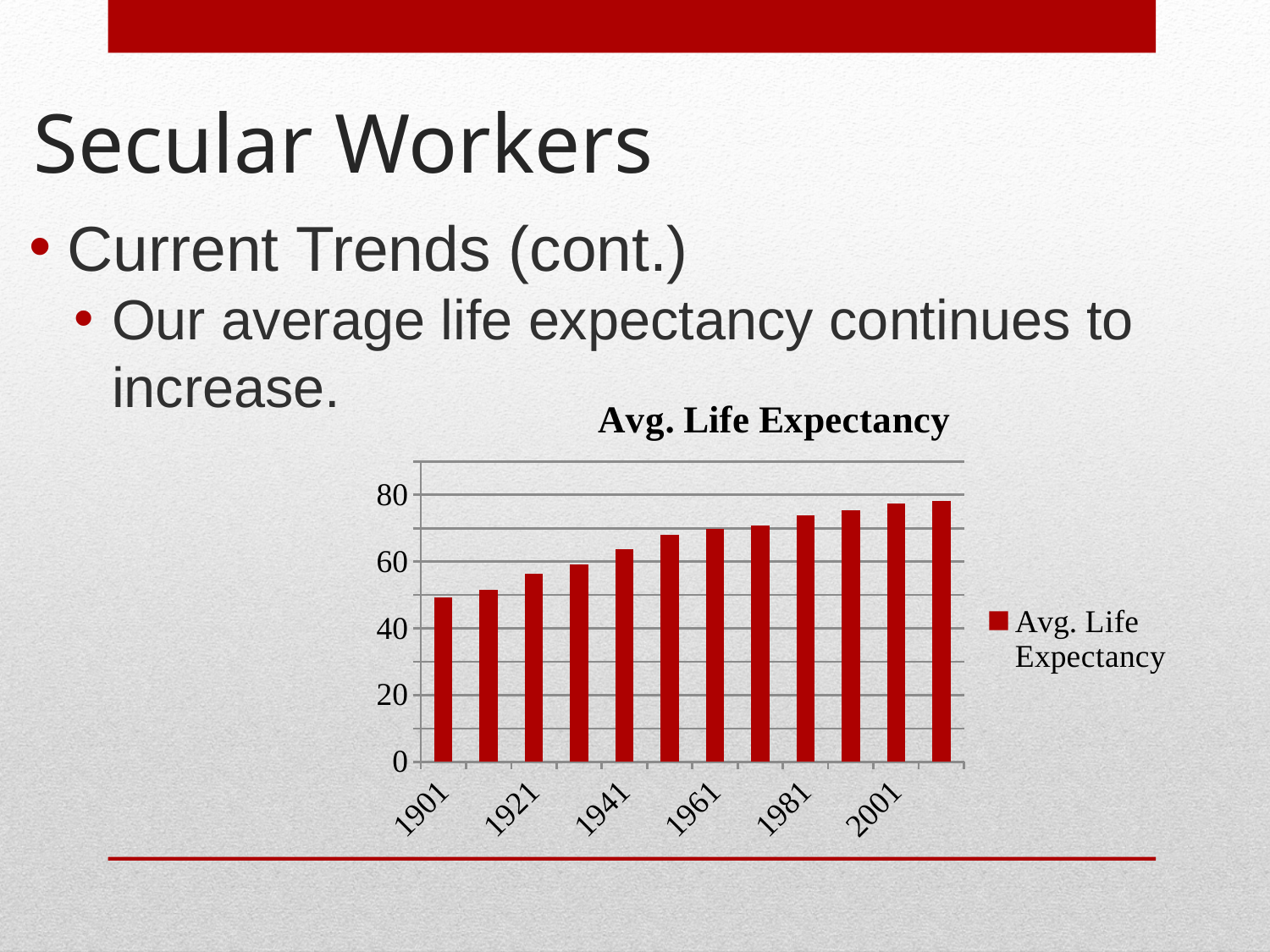
Is the value for 1901 greater or less than 60? less What colour are the bars in the chart? red Is the value for 1961 greater or less than 60? greater How many series does the chart's legend list? 1 How many bars are plotted in the chart? 12 Is the value for 1941 greater or less than 60? greater Do the values rise or fall from left to right along the x axis? rise What kind of chart is shown on the slide? bar chart What is the title of the chart? Avg. Life Expectancy Which is larger, the value for 1921 or the value for 1981? 1981 Which labeled year has the lowest average life expectancy? 1901